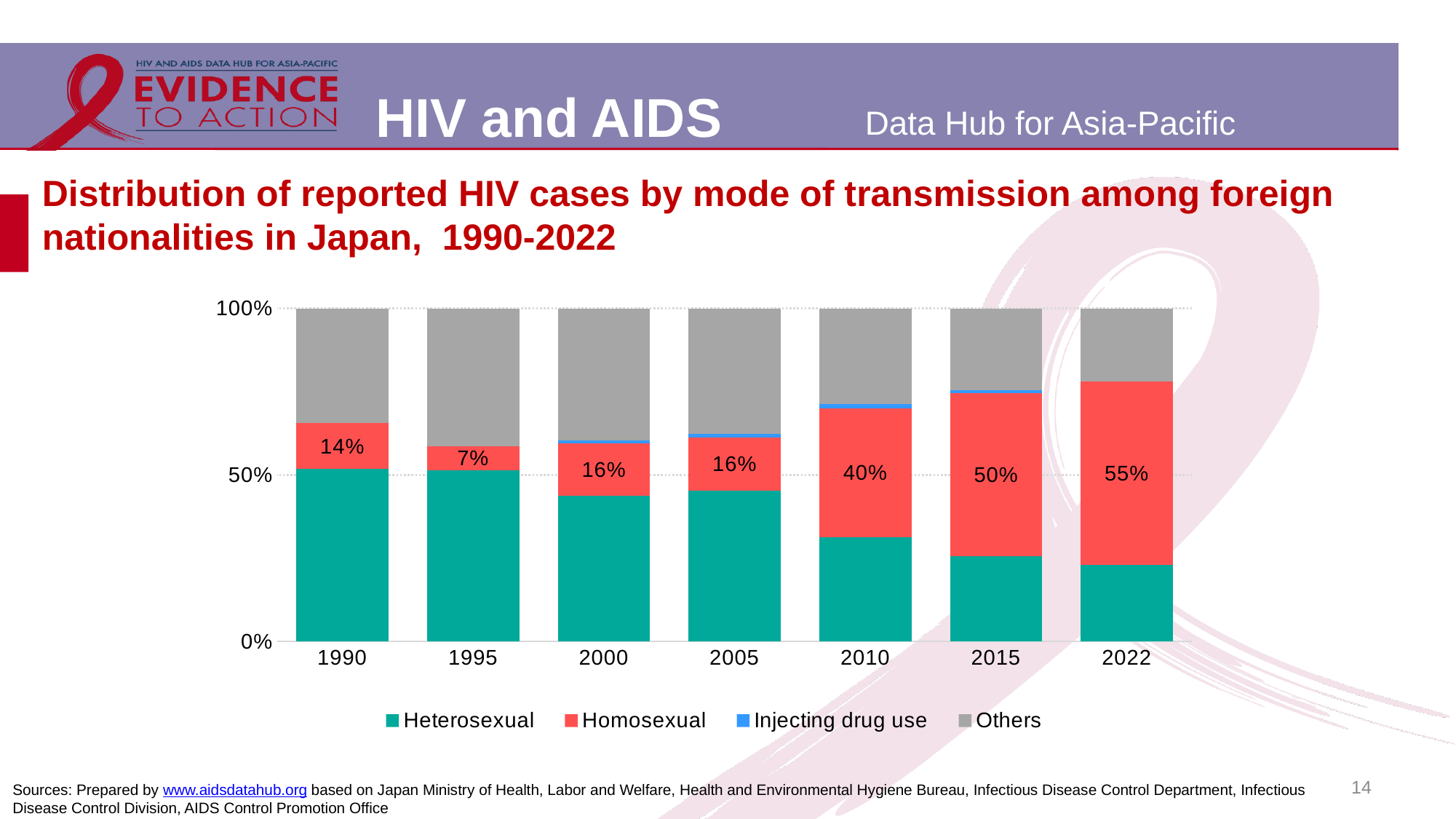
Which year has a larger Homosexual share, 2005 or 2010? 2010 By how many percentage points did the Homosexual share increase from 1990 to 2022? 41 How many modes of transmission does the legend list? 4 In which year is the Homosexual share the highest? 2022 What is the Homosexual share shown for 2022? 55% What kind of chart is used on this slide? Stacked bar chart What percentage of reported HIV cases among foreign nationalities in Japan were attributed to homosexual transmission in 1990? 14% In which year is the Homosexual share the lowest? 1995 What is the Homosexual share shown for 1995? 7% What is the Homosexual share shown for 2010? 40% How many years are shown on the x axis of the chart? 7 Is the Heterosexual share in 2022 greater or less than 50%? less